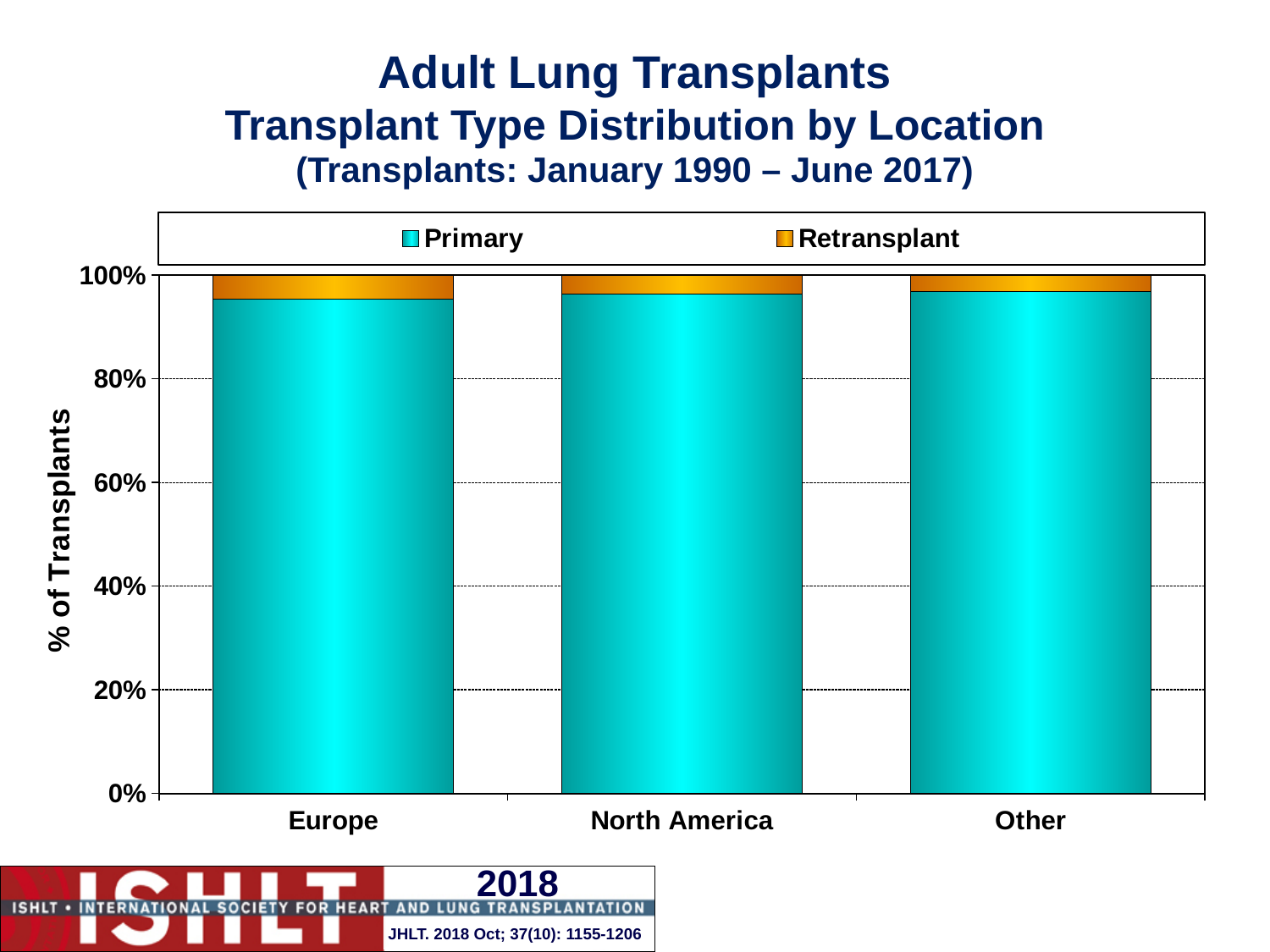
What is the label of the y axis? % of Transplants Is the Retransplant value for North America greater or less than 20%? less What time period of transplants does the chart title cover? January 1990 – June 2017 What kind of chart is shown on the slide? stacked bar chart Which two series are listed in the legend? Primary and Retransplant For Europe, which is larger, the Primary share or the Retransplant share? Primary Which location has the largest Retransplant share? Europe What is the total height of the stacked bar for North America? 100% Is the Primary value for Europe greater or less than 80%? greater Is the Primary value for Other greater or less than 60%? greater How many series does the legend list? 2 How many location categories are shown on the x axis? 3